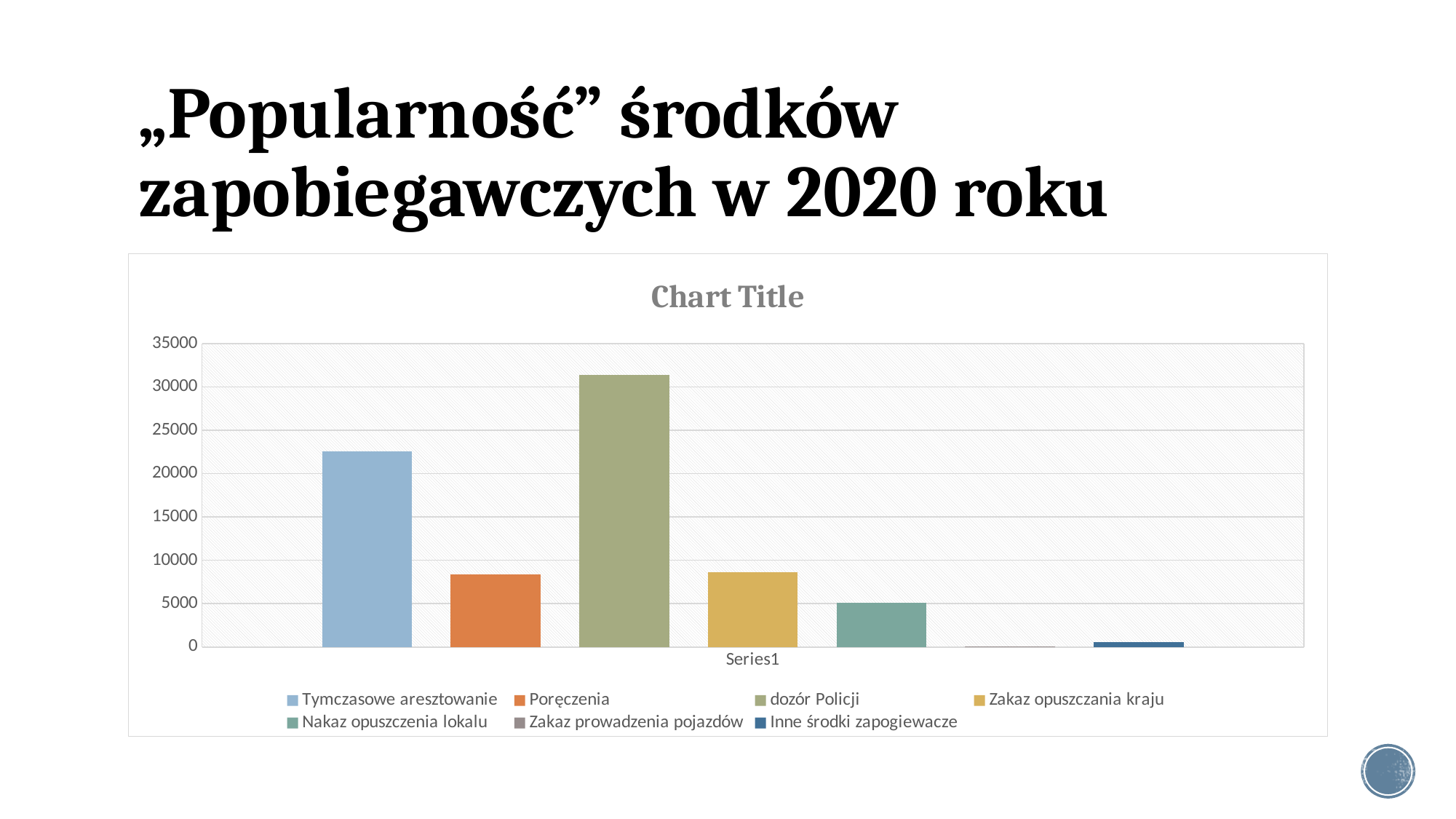
How many series does the legend list? 7 What label appears on the x axis below the bars? Series1 Is the value for dozór Policji greater or less than 30000? greater Which is larger, the value for Tymczasowe aresztowanie or the value for Poręczenia? Tymczasowe aresztowanie Which series has the highest bar? dozór Policji Which is larger, the value for dozór Policji or the value for Tymczasowe aresztowanie? dozór Policji Which series has the lowest bar? Zakaz prowadzenia pojazdów Is the value for Inne środki zapogiewacze greater or less than 5000? less What kind of chart is shown on the slide? bar chart Is the value for Tymczasowe aresztowanie greater or less than 20000? greater What is the title shown above the chart? Chart Title